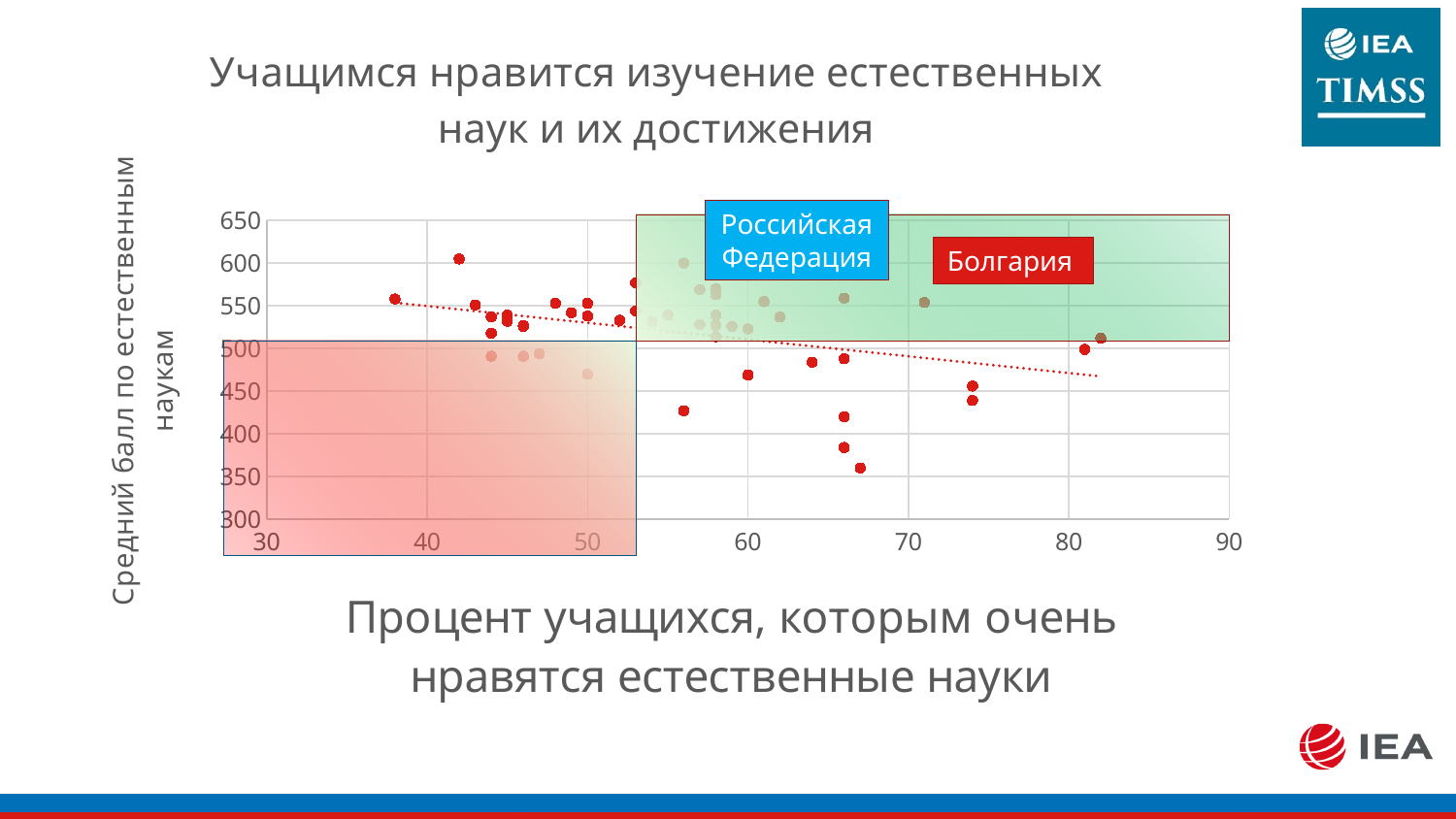
What is the title of the chart on the slide? Учащимся нравится изучение естественных наук и их достижения What is the highest tick value shown on the vertical axis? 650 What is the lowest tick value shown on the horizontal axis? 30 What is the lowest tick value shown on the vertical axis? 300 What kind of chart is shown on the slide? Scatter chart Does the dotted trend line rise or fall as the horizontal axis value increases? Fall Is the lowest plotted point on the chart greater or less than 400 on the vertical axis? less What is the label of the horizontal axis of the chart? Процент учащихся, которым очень нравятся естественные науки What is the highest tick value shown on the horizontal axis? 90 How many countries are named in callout labels on the chart? 2